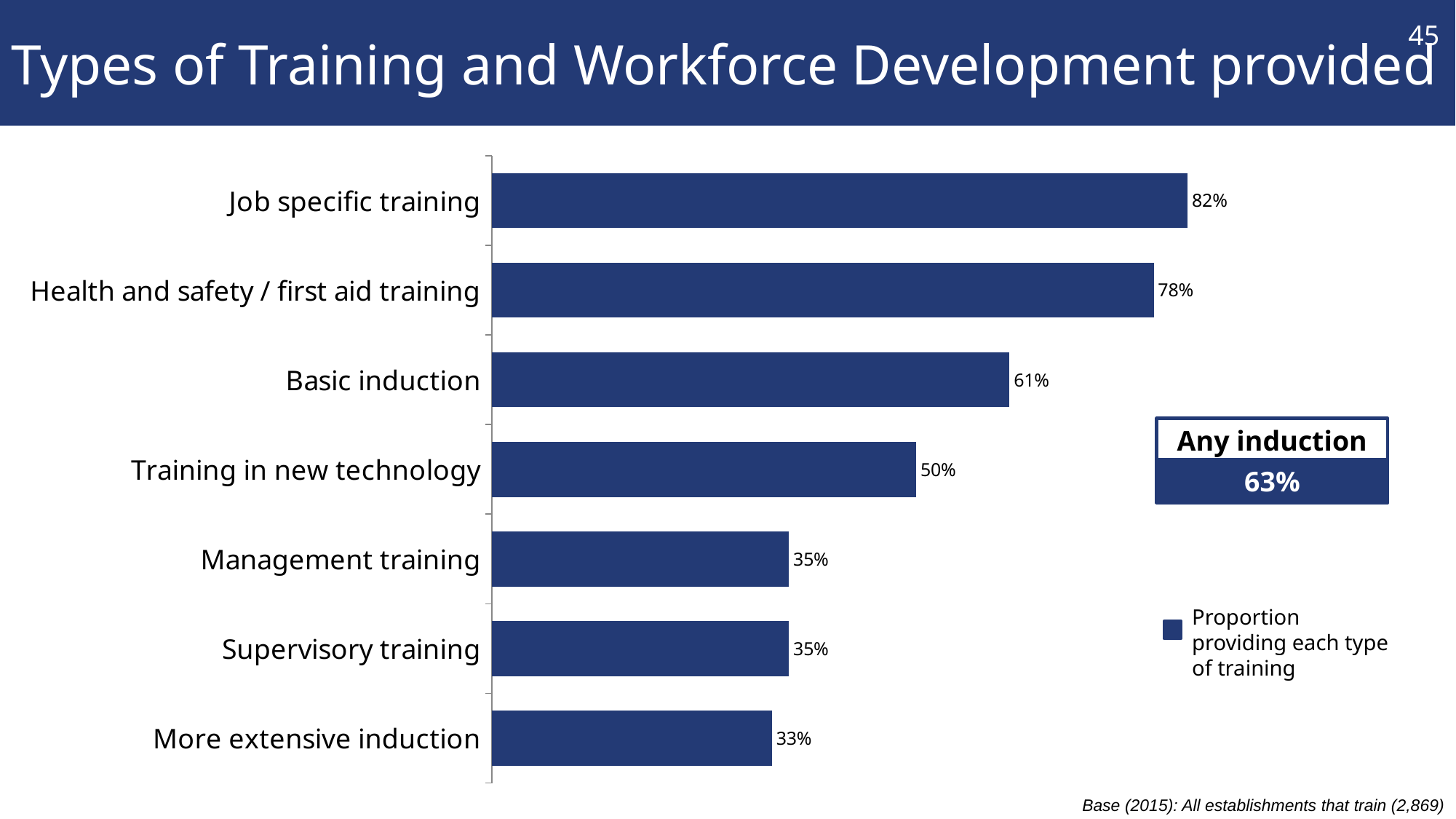
What is the value for More extensive induction? 33% What does the legend say the bars represent? Proportion providing each type of training What is the difference in percentage points between Basic induction and More extensive induction? 28 Which is larger, the value for Basic induction or the value for Training in new technology? Basic induction How many types of training are shown as bars in the chart? 7 What is the difference in percentage points between Job specific training and Health and safety / first aid training? 4 Which type of training has the lowest proportion? More extensive induction Which type of training has the highest proportion of establishments providing it? Job specific training What value is shown in the 'Any induction' box? 63% What kind of chart is shown on the slide? Bar chart What is the value for Training in new technology? 50% What percentage of establishments provide job specific training? 82%